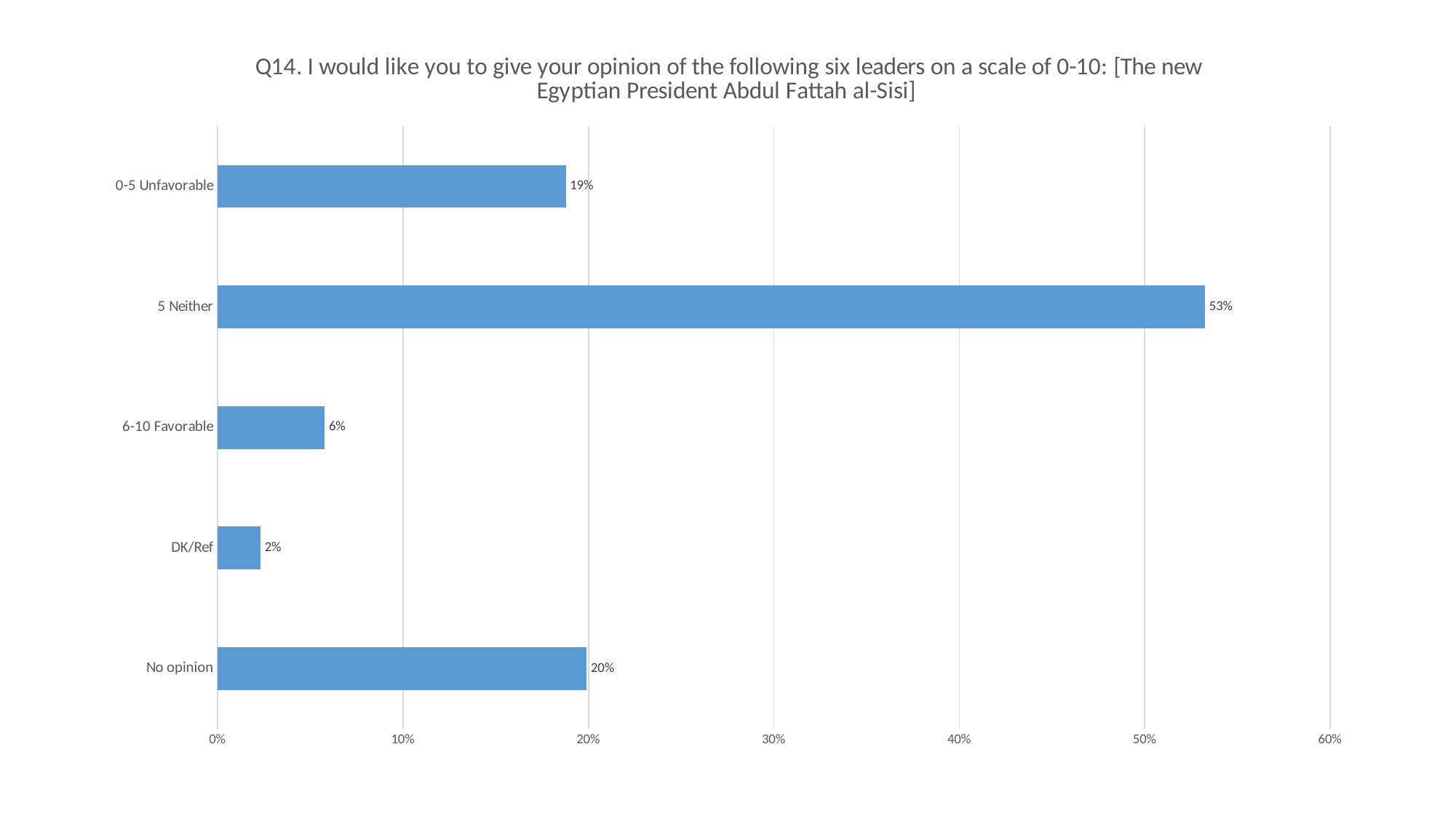
Which category has the highest value? 5 Neither Which is larger, the value for 0-5 Unfavorable or the value for 6-10 Favorable? 0-5 Unfavorable What is the value for No opinion? 20% What is the value for 0-5 Unfavorable? 19% What type of chart is shown on the slide? bar chart What percentage of respondents gave a rating of 5 Neither? 53% Is the value for 5 Neither greater or less than 50%? greater What is the difference between the 5 Neither value and the 0-5 Unfavorable value? 34% What is the value for DK/Ref? 2% How many categories are shown in the chart? 5 Which category has the lowest value? DK/Ref What is the value for 6-10 Favorable? 6%